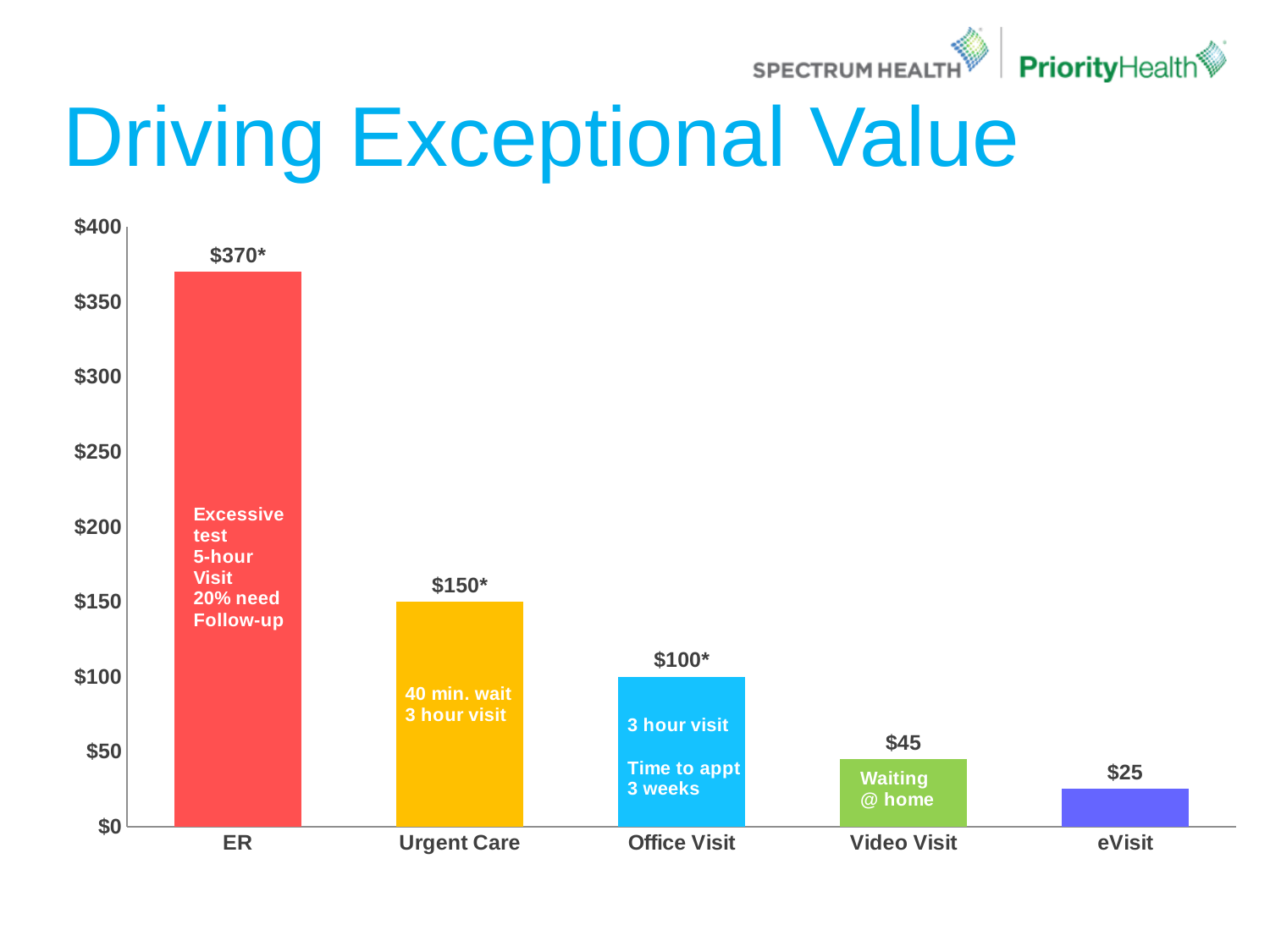
What kind of chart is shown on the slide? bar chart Is the value for Video Visit greater or less than $50? less What is the difference between the Office Visit value and the eVisit value? $75 Do the values rise or fall moving from ER to eVisit along the x axis? fall What is the difference between the ER value and the Urgent Care value? $220 Which category has the highest value? ER What is the value shown for ER? $370* How many categories are shown on the x axis? 5 What is the value shown for Video Visit? $45 Which is larger, the value for Urgent Care or the value for Office Visit? Urgent Care What is the value shown for eVisit? $25 Which category has the lowest value? eVisit